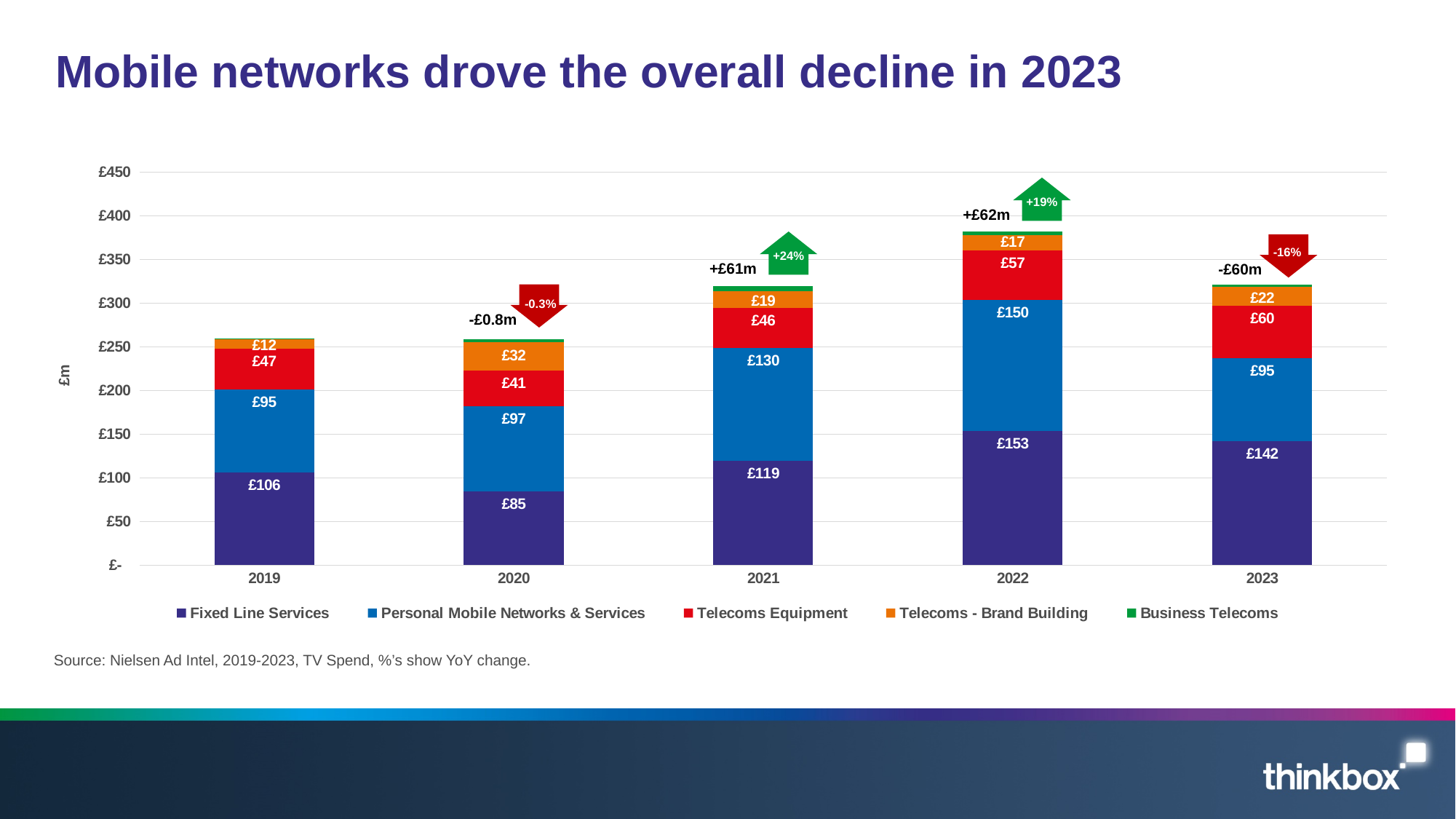
Which is larger: Fixed Line Services in 2019 or Fixed Line Services in 2020? 2019 What year-on-year percentage change is shown above the 2023 bar? -16% In which year is the Fixed Line Services value highest? 2022 How many years are shown on the x axis? 5 What kind of chart is shown on the slide? Stacked bar chart What is the difference between the Personal Mobile Networks & Services values in 2022 and 2023? £55 In which year is the Telecoms Equipment value lowest? 2020 What is the value for Fixed Line Services in 2022? £153 What is the value for Telecoms - Brand Building in 2020? £32 How many series does the legend list? 5 What is the value for Personal Mobile Networks & Services in 2023? £95 What is the value for Telecoms Equipment in 2021? £46